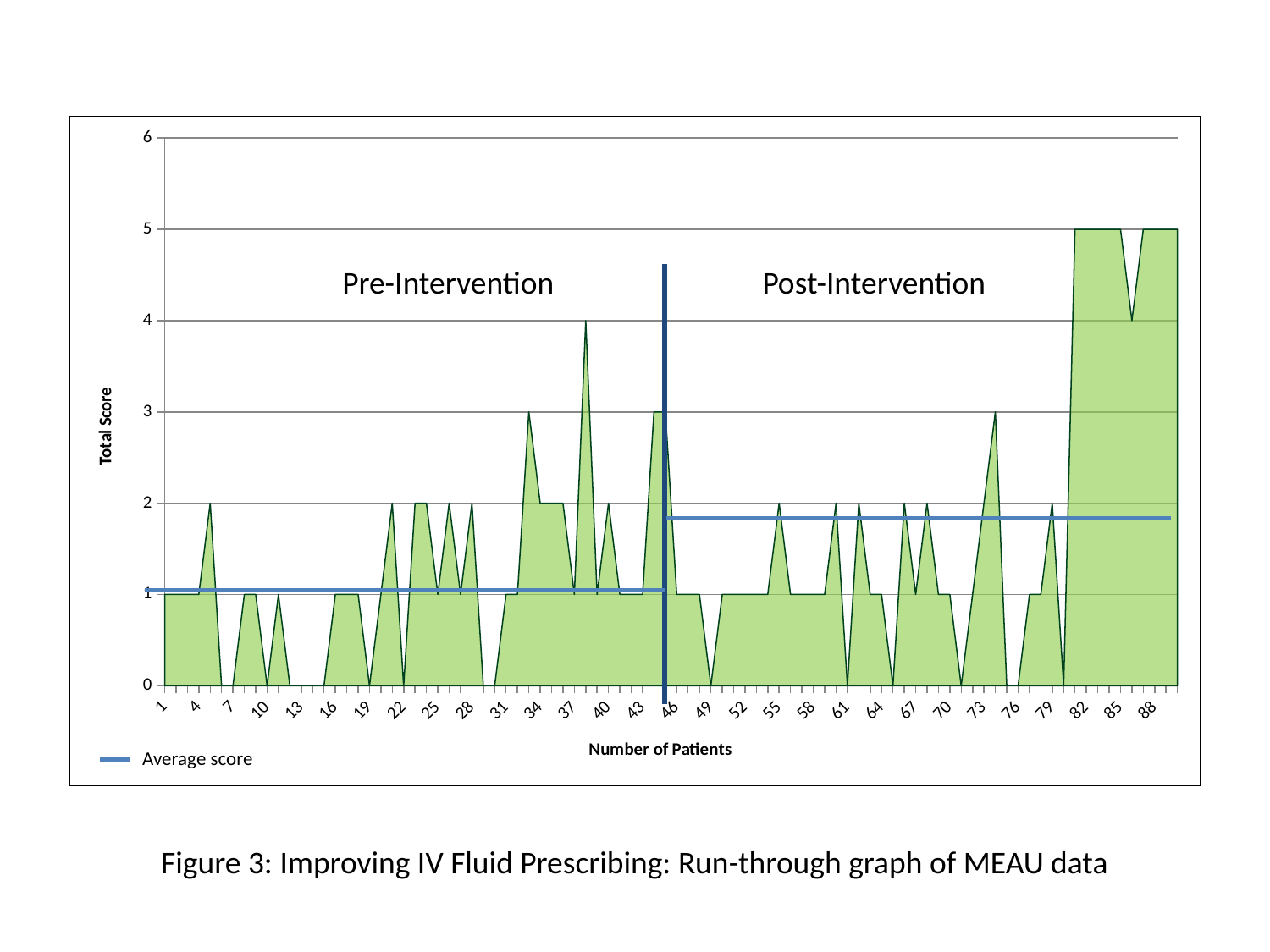
Is the Pre-Intervention average score greater or less than 2? less Which section has the higher average score line, Pre-Intervention or Post-Intervention? Post-Intervention What is the Total Score for patient 82? 5 What is the highest Total Score reached in the Pre-Intervention section? 4 What is the label of the vertical axis? Total Score Is the Post-Intervention average score greater or less than 1? greater What is the highest Total Score reached by any patient on the chart? 5 What is the Total Score for patient 1? 1 What entry does the legend list? Average score Is the Post-Intervention average score greater or less than 2? less What is the highest value shown on the vertical axis? 6 What kind of chart is shown on the slide? Area chart